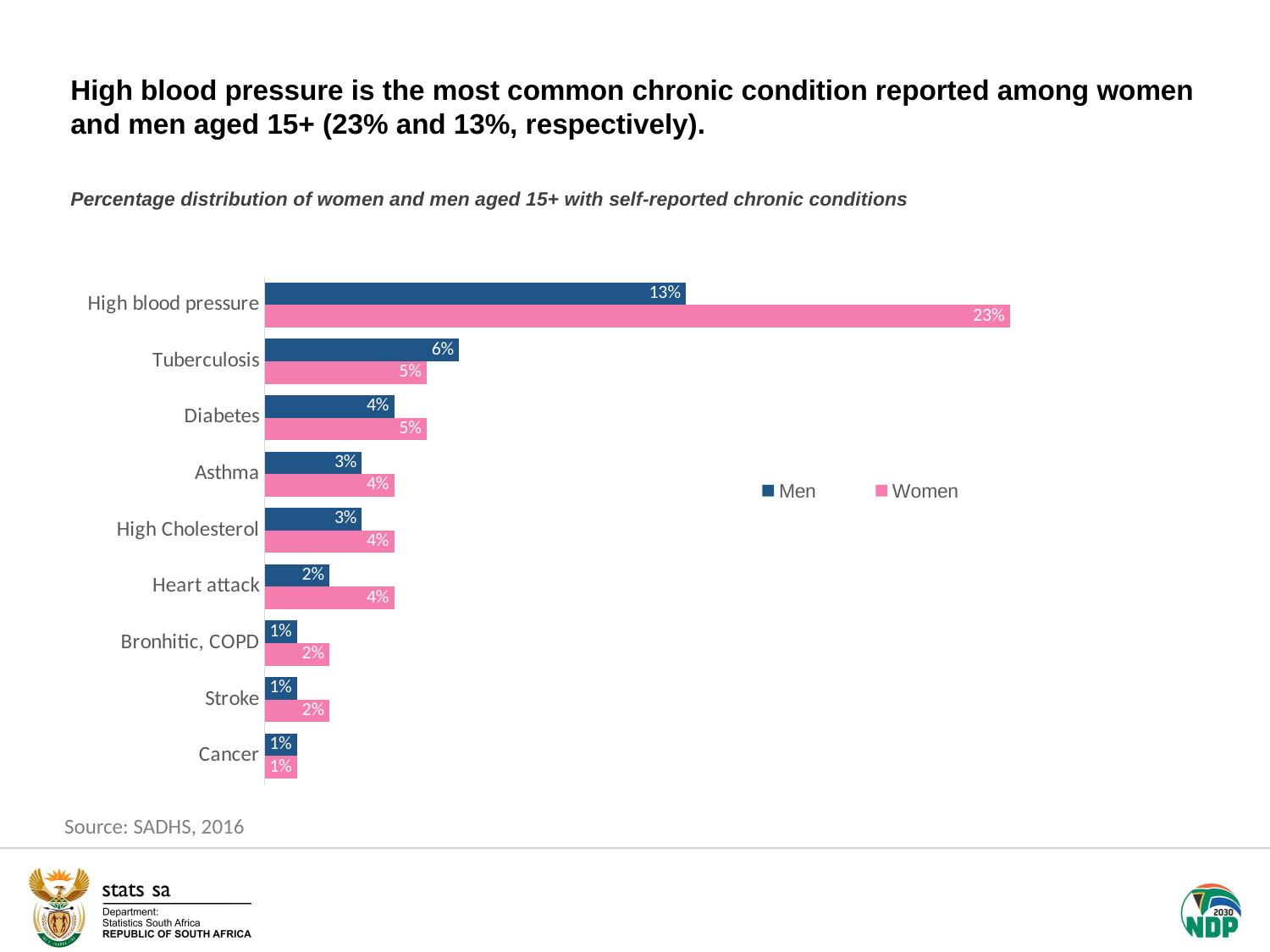
What is the value for women for heart attack? 4% What percentage of women reported high blood pressure? 23% What kind of chart is shown on the slide? Bar chart Which chronic condition has the highest value for men? High blood pressure How many chronic conditions are shown on the chart? 9 Which chronic condition has the lowest value for women? Cancer For tuberculosis, which is larger: the value for men or the value for women? Men Which colour represents women in the chart? Pink What is the difference between the women's and men's values for high blood pressure? 10% What percentage of men reported tuberculosis? 6% How many series does the legend list? 2 For diabetes, which is larger: the value for men or the value for women? Women